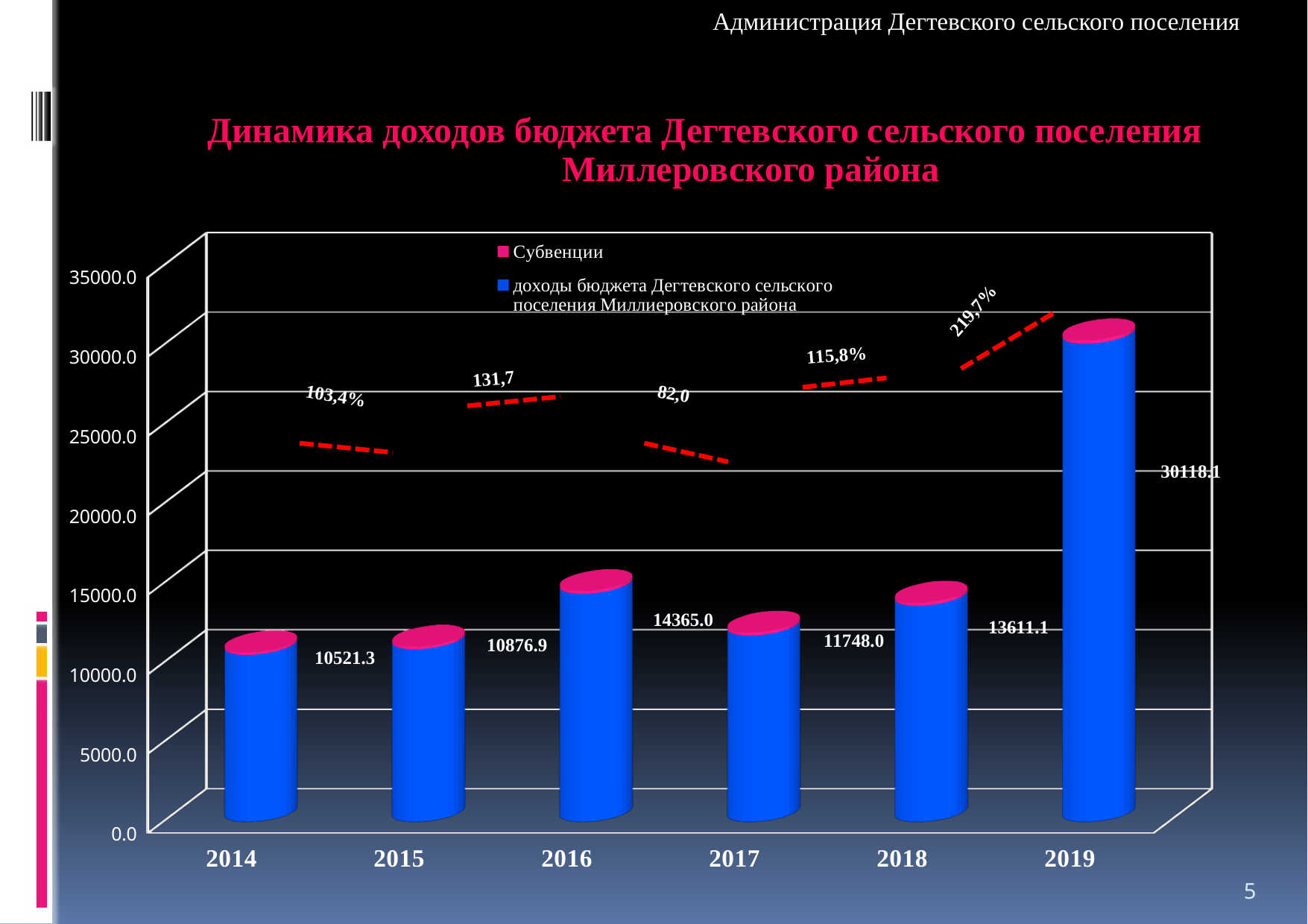
What is the budget income value shown for 2016? 14365.0 How many years are shown on the x axis? 6 What is the difference between the budget income in 2019 and in 2018? 16507.0 Which year has the lowest budget income? 2014 How many series does the legend list? 2 What is the budget income value shown for 2019? 30118.1 Is the budget income for 2019 greater or less than 25000.0? greater What is the budget income value shown for 2017? 11748.0 Which year has the highest budget income? 2019 What is the budget income value shown for 2014? 10521.3 What percentage annotation is shown above the dashed line between 2018 and 2019? 219,7% Which year has the larger budget income, 2016 or 2017? 2016